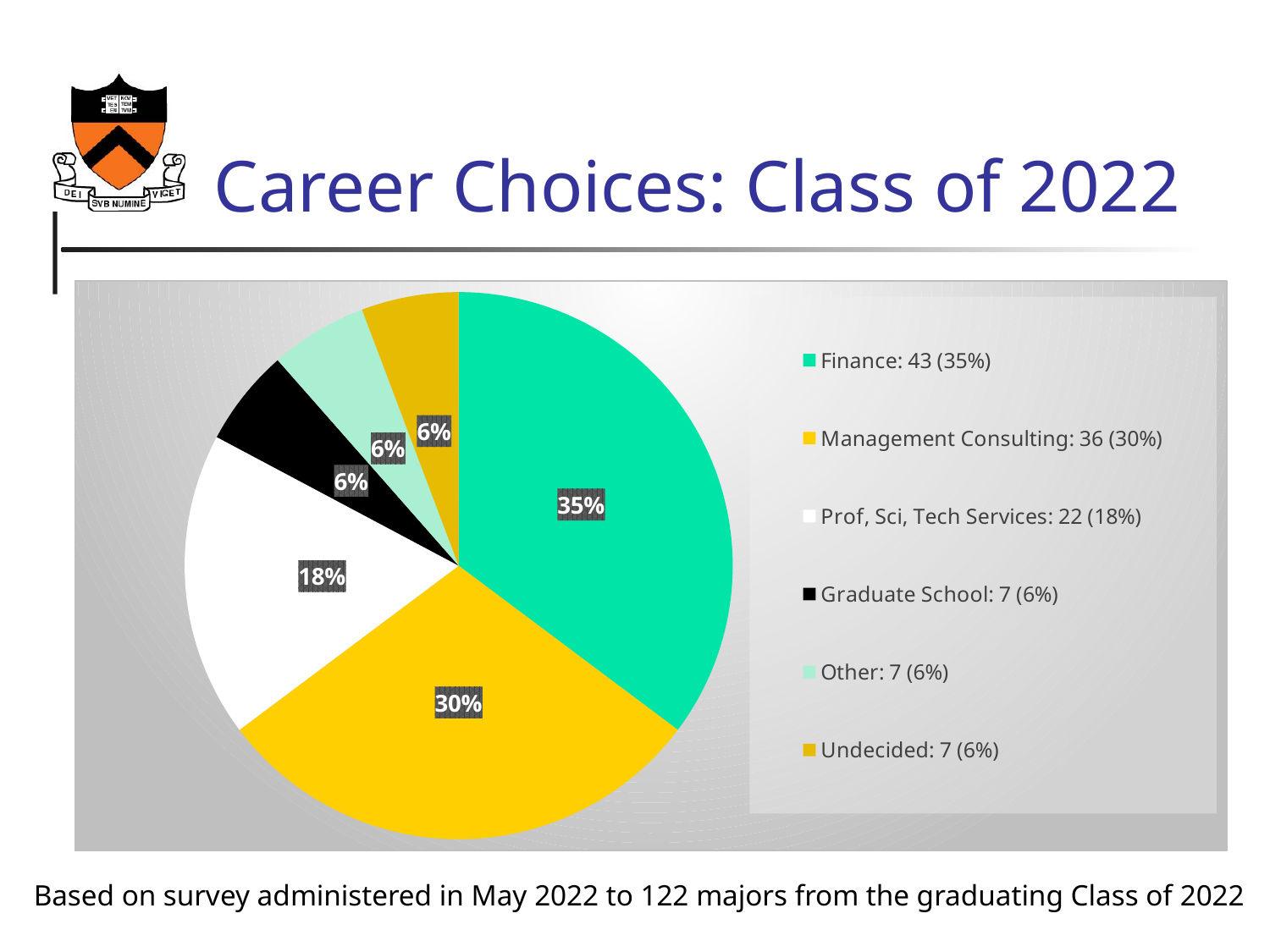
What share of the pie is Prof, Sci, Tech Services? 18% What is the difference in percentage points between Finance and Graduate School? 29 What kind of chart is shown on the slide? pie chart Which category has the largest slice of the pie? Finance Which is larger, the Management Consulting slice or the Prof, Sci, Tech Services slice? Management Consulting What percentage of the pie does Finance represent? 35% How many categories does the legend list? 6 What is the difference in count between Finance and Management Consulting? 7 How many graduates chose Management Consulting according to the legend? 36 What colour is the Finance slice of the pie? green How many graduates are listed as Undecided? 7 What is the title of the slide containing the chart? Career Choices: Class of 2022